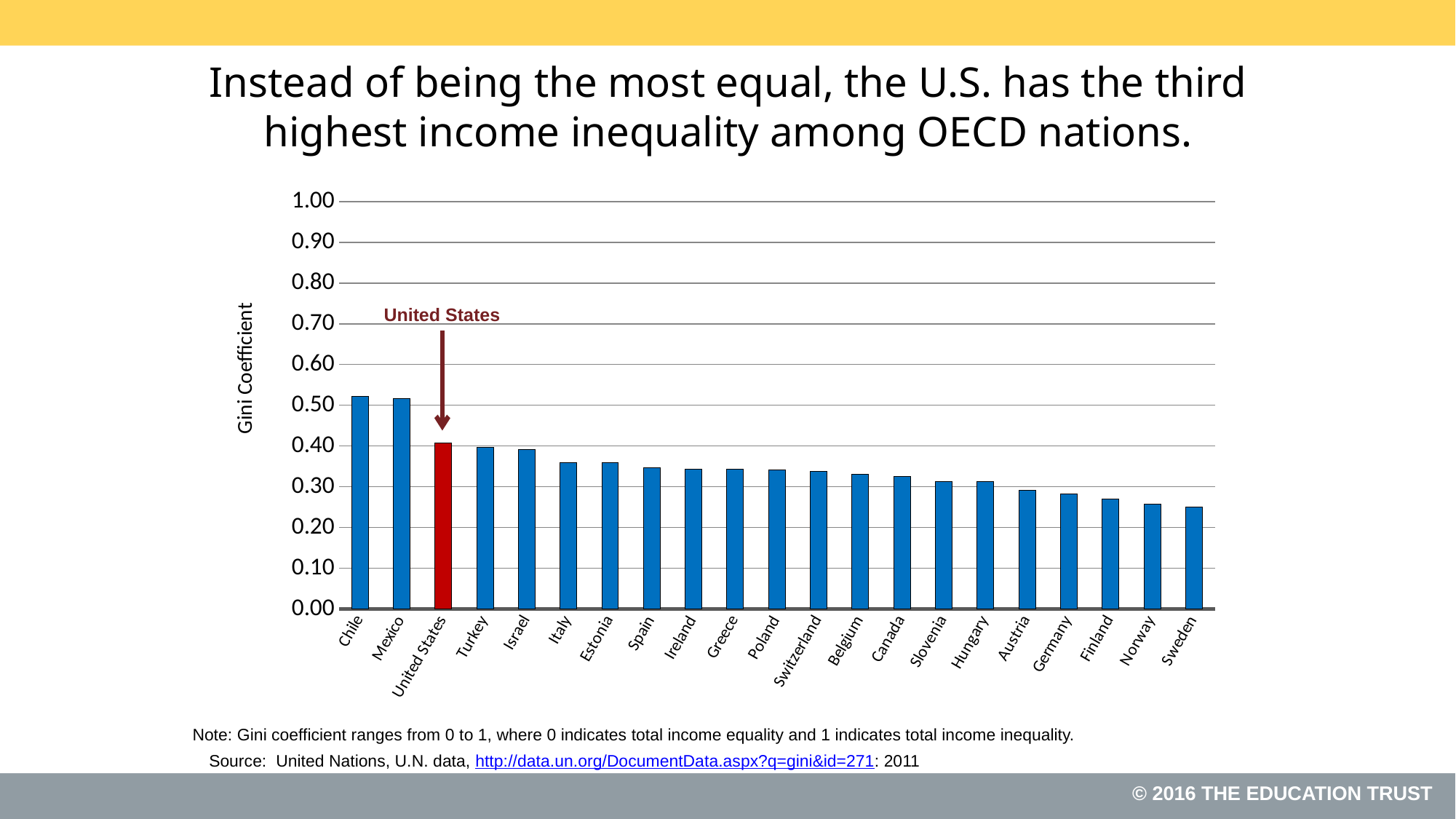
How many countries are shown on the x axis of the chart? 21 What is the label on the vertical axis of the chart? Gini Coefficient Is the Gini coefficient for Italy greater or less than 0.40? less Is the Gini coefficient for Germany greater or less than 0.30? less Is the Gini coefficient for Sweden greater or less than 0.30? less Which has a higher Gini coefficient, Mexico or the United States? Mexico Which country's bar is highlighted in red on the chart? United States What kind of chart is shown on the slide? Bar chart Do the Gini coefficient values rise or fall moving from left to right along the x axis? Fall Which has a higher Gini coefficient, Italy or Germany? Italy